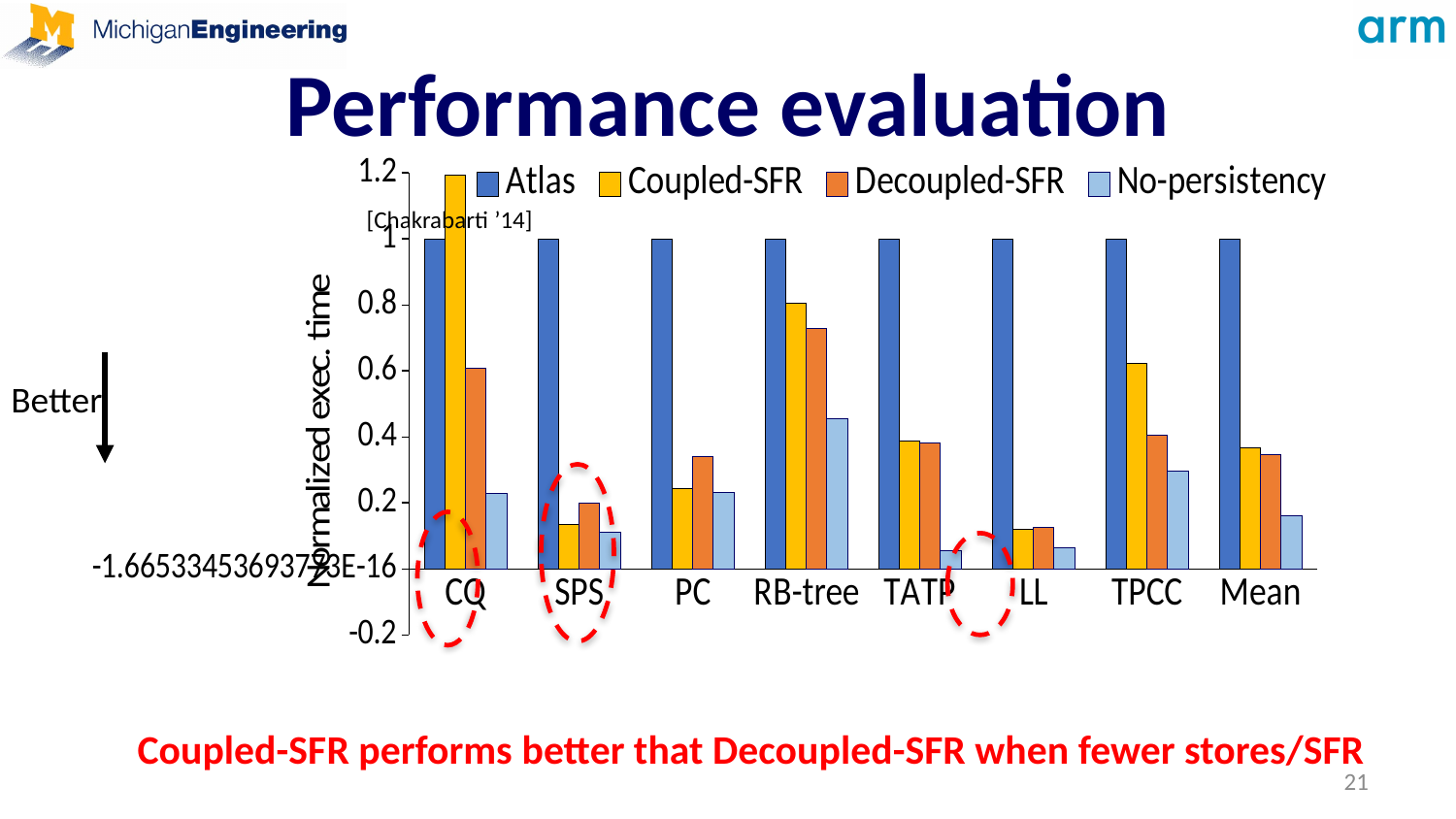
Is the Decoupled-SFR value for RB-tree greater or less than 0.6? greater What is the value of the Atlas bar for Mean? 1 Is the Coupled-SFR value for SPS greater or less than 0.2? less For PC, which is larger: the Coupled-SFR value or the Decoupled-SFR value? Decoupled-SFR What is the value of the Atlas bar for RB-tree? 1 What is the label of the chart's y axis? Normalized exec. time How many categories are shown along the x axis of the chart? 8 How many series does the chart's legend list? 4 Which category has the highest Coupled-SFR value? CQ Which category has the highest Decoupled-SFR value? RB-tree Is the Coupled-SFR value for CQ greater or less than 1? greater What kind of chart is shown on the slide? bar chart